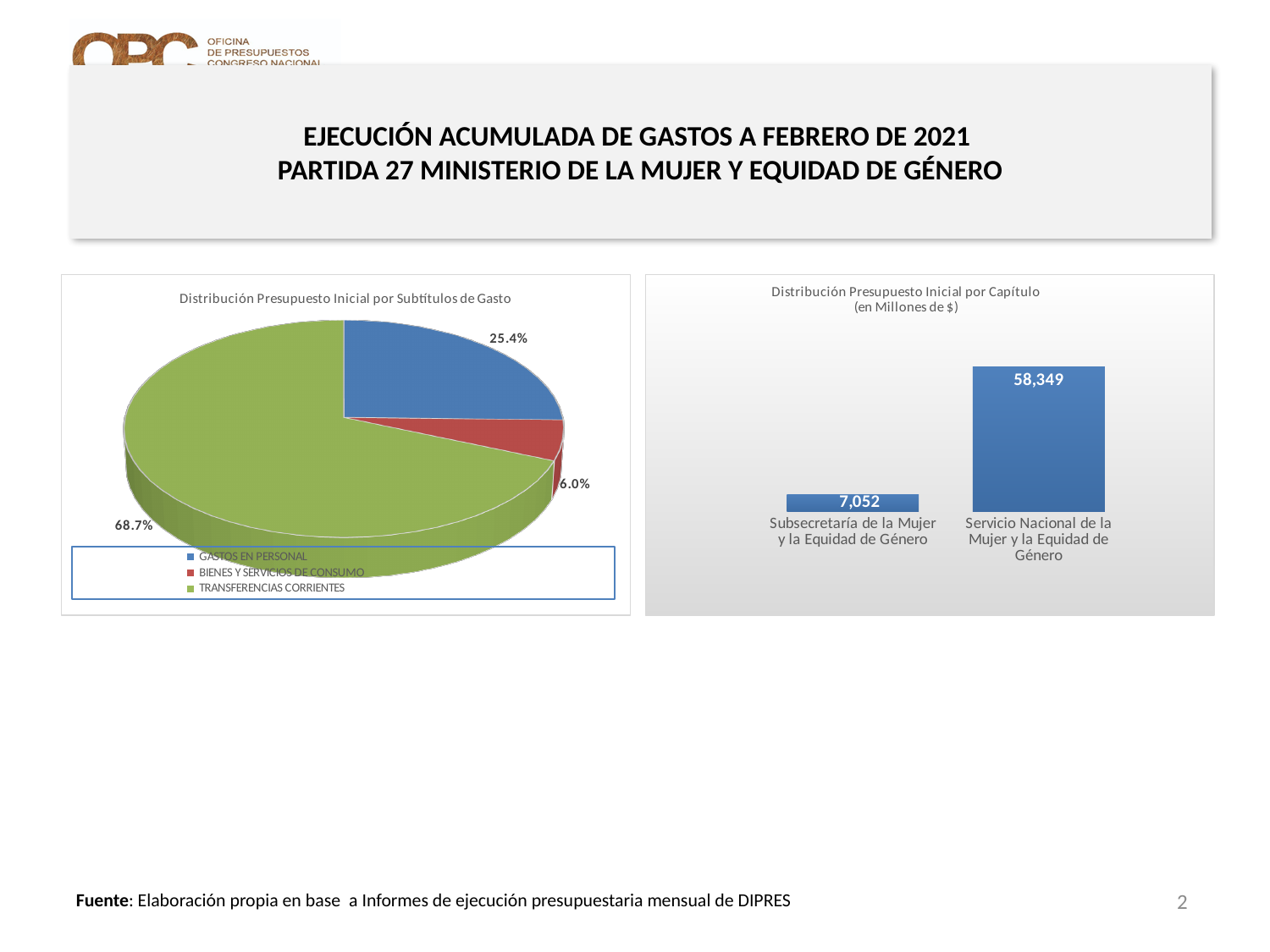
In the chart titled 'Distribución Presupuesto Inicial por Subtítulos de Gasto', what share does TRANSFERENCIAS CORRIENTES have? 68.7% In the chart titled 'Distribución Presupuesto Inicial por Capítulo', what is the difference between the values for Servicio Nacional de la Mujer y la Equidad de Género and Subsecretaría de la Mujer y la Equidad de Género? 51,297 In the chart titled 'Distribución Presupuesto Inicial por Subtítulos de Gasto', what share does BIENES Y SERVICIOS DE CONSUMO have? 6.0% What kind of chart is the one titled 'Distribución Presupuesto Inicial por Subtítulos de Gasto'? Pie chart What kind of chart is the one titled 'Distribución Presupuesto Inicial por Capítulo'? Bar chart In the chart titled 'Distribución Presupuesto Inicial por Capítulo', what is the value for Servicio Nacional de la Mujer y la Equidad de Género? 58,349 In the chart titled 'Distribución Presupuesto Inicial por Subtítulos de Gasto', which category has the smallest slice? BIENES Y SERVICIOS DE CONSUMO In the chart titled 'Distribución Presupuesto Inicial por Subtítulos de Gasto', how many categories does the legend list? 3 In the chart titled 'Distribución Presupuesto Inicial por Subtítulos de Gasto', which category has the largest slice? TRANSFERENCIAS CORRIENTES In the chart titled 'Distribución Presupuesto Inicial por Subtítulos de Gasto', what share does GASTOS EN PERSONAL have? 25.4% In the chart titled 'Distribución Presupuesto Inicial por Subtítulos de Gasto', what colour is the GASTOS EN PERSONAL slice? Blue In the chart titled 'Distribución Presupuesto Inicial por Capítulo', what is the value for Subsecretaría de la Mujer y la Equidad de Género? 7,052